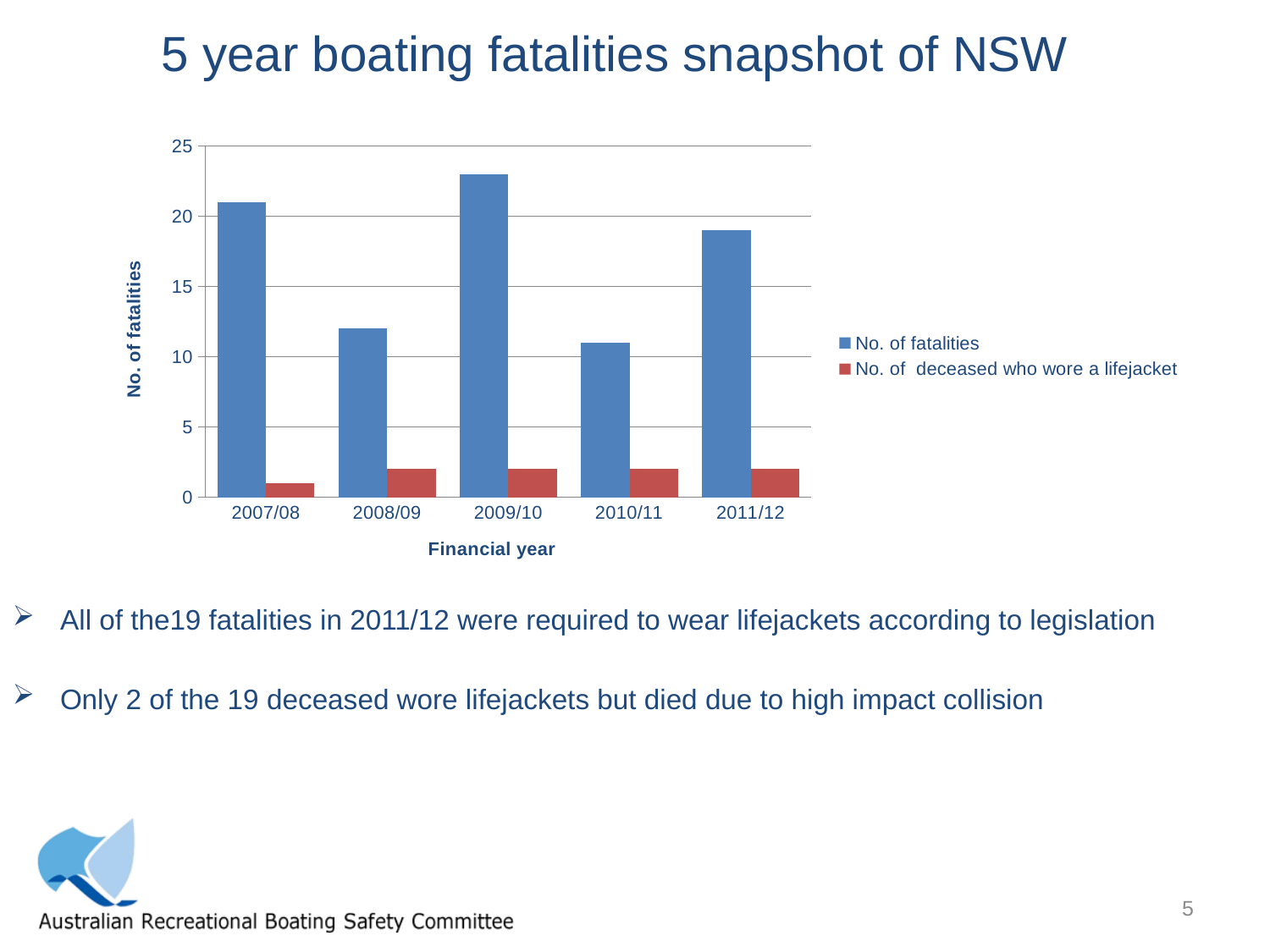
What is the title of the x axis of the chart? Financial year How many fatalities were there in 2011/12? 19 Which year had more fatalities, 2007/08 or 2008/09? 2007/08 Is the number of fatalities for 2007/08 greater or less than 20? greater Is the number of fatalities for 2010/11 greater or less than 15? less Which financial year has the highest number of fatalities? 2009/10 What type of chart is shown on the slide? Bar chart How many of the deceased wore a lifejacket in 2011/12? 2 Which financial year has the lowest number of deceased who wore a lifejacket? 2007/08 What is the title of the y axis of the chart? No. of fatalities How many series does the chart legend list? 2 How many financial years are shown on the x axis of the chart? 5